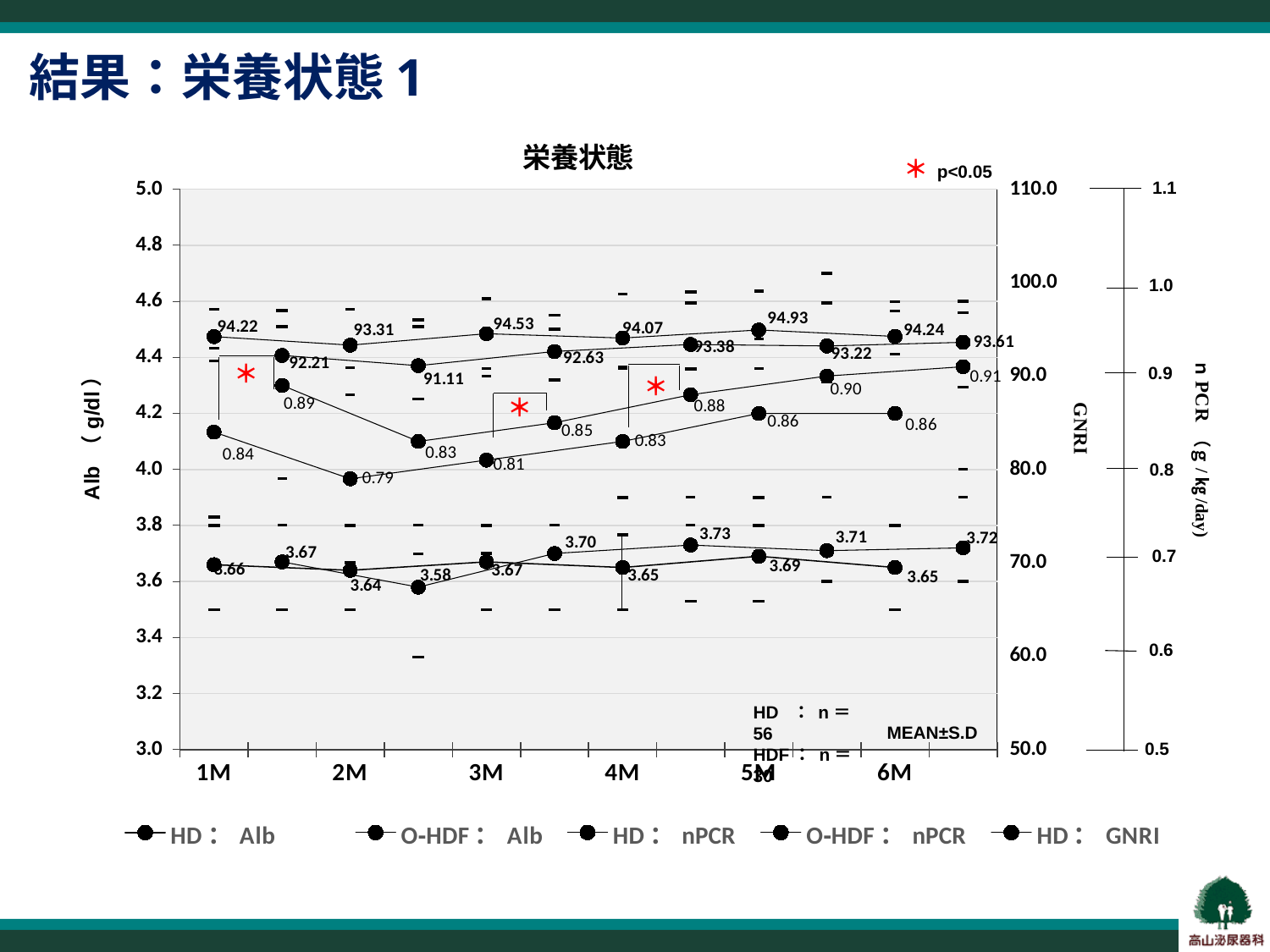
How many series does the legend list? 5 What is the HD: GNRI value at 1M? 94.22 Which is larger, the HD: Alb value at 3M or at 4M? 3M What significance level is indicated by the red asterisk? p<0.05 What is the title of the chart? 栄養状態 What is the HD: Alb value at 5M? 3.69 How many time points are shown on the x axis? 6 At which time point is the HD: nPCR value lowest? 2M What is the difference between the HD: GNRI values at 5M and 2M? 1.62 At which time point is the HD: GNRI value highest? 5M What is the HD: nPCR value at 2M? 0.79 What type of chart is shown on the slide? line chart